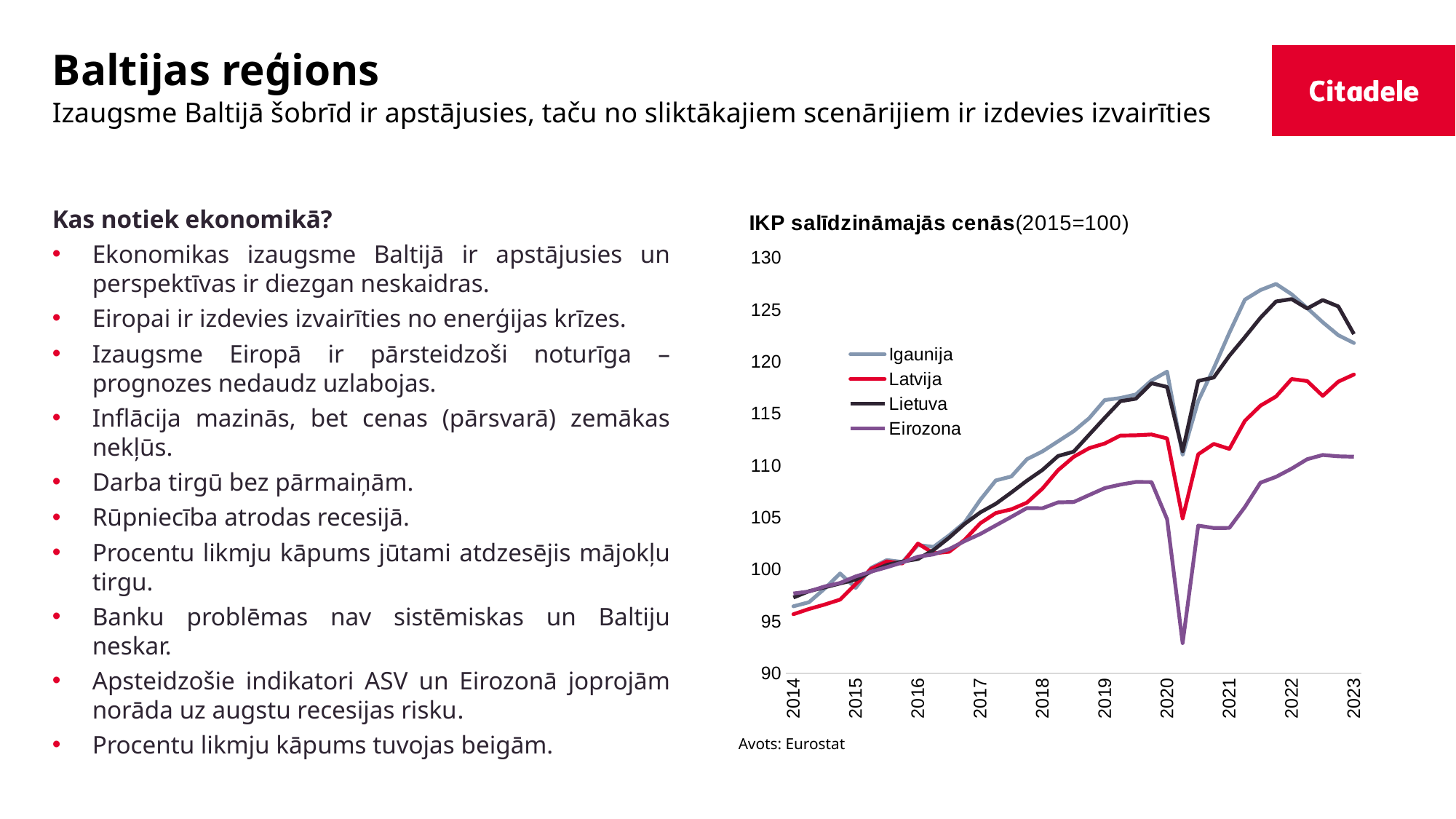
Which series is the lowest at the end of the chart in 2023? Eirozona At 2023, which is higher: Lietuva or Latvija? Lietuva How many series does the chart legend list? 4 Is the lowest value of Eirozona in 2020 greater or less than 95? less Is the peak value of Igaunija greater or less than 125? greater Does the Eirozona series rise or fall from 2014 to 2019? rise Which series are listed in the chart legend? Igaunija, Latvija, Lietuva, Eirozona Which series drops to the lowest value in 2020? Eirozona How many year labels are shown on the x axis? 10 Is the value for Eirozona in 2023 greater or less than 115? less What kind of chart is shown on the slide? line chart What is the title of the chart? IKP salīdzināmajās cenās (2015=100)